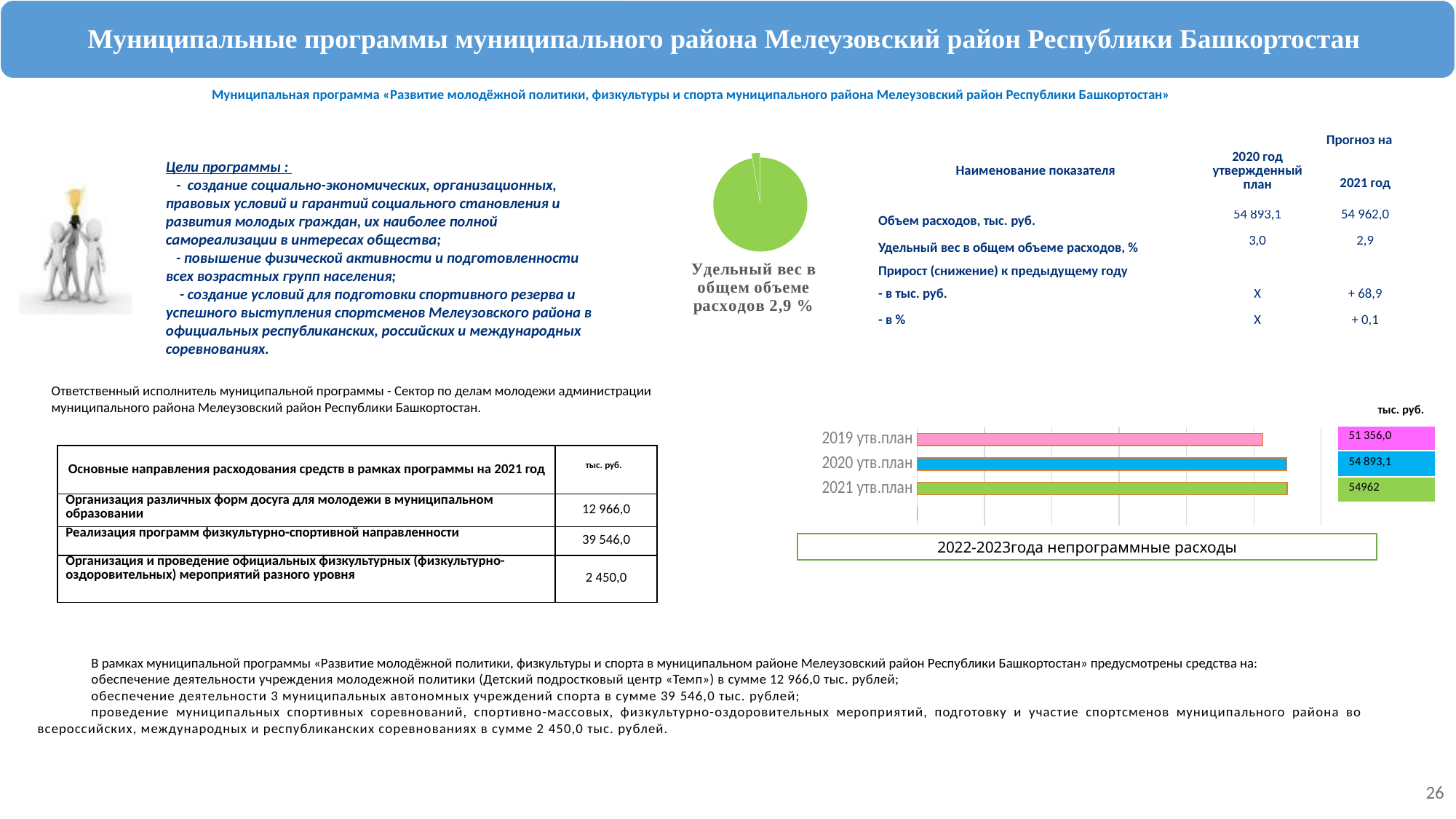
In the bar chart at the bottom right, what is the difference between the values for 2020 утв.план and 2019 утв.план? 3 537,1 What kind of chart is shown in the upper middle of the slide next to the programme goals? pie chart In the bar chart at the bottom right, what is the value for 2019 утв.план? 51 356,0 According to the caption under the pie chart, what share of total expenditure does the programme represent? 2,9 % In the bar chart at the bottom right, what unit is indicated above the chart? тыс. руб. In the bar chart at the bottom right, what is the value for 2021 утв.план? 54962 In the bar chart at the bottom right, is the value for 2020 утв.план larger or smaller than the value for 2019 утв.план? larger In the bar chart at the bottom right, which category has the lowest value? 2019 утв.план In the bar chart at the bottom right, what is the value for 2020 утв.план? 54 893,1 In the bar chart at the bottom right, what colour is the bar for 2021 утв.план? green In the bar chart at the bottom right, how many bars are plotted? 3 What kind of chart is shown at the bottom right of the slide? bar chart